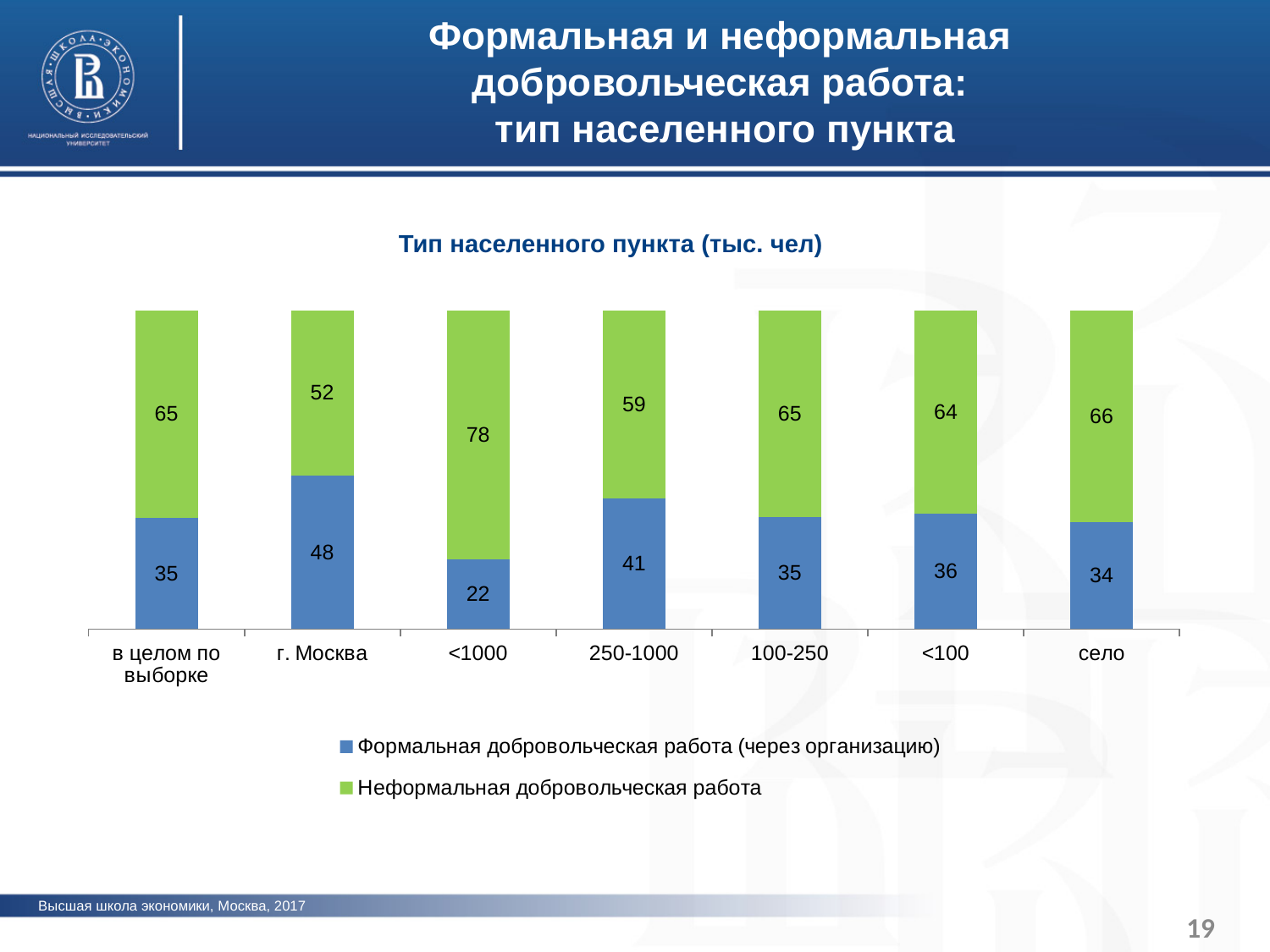
How many series does the legend list? 2 Which category has the lowest value for formal volunteer work (Формальная добровольческая работа)? <1000 Which is larger: the formal volunteer work value for 250-1000 or for 100-250? 250-1000 How many categories are shown on the x axis? 7 What kind of chart is shown on the slide? Stacked bar chart What is the total of the stacked bar for г. Москва? 100 Which category has the highest value for formal volunteer work (Формальная добровольческая работа)? г. Москва What is the value for formal volunteer work (Формальная добровольческая работа) in г. Москва? 48 What is the value for formal volunteer work in the село category? 34 What is the value for informal volunteer work (Неформальная добровольческая работа) for the <1000 category? 78 Which category has the highest value for informal volunteer work (Неформальная добровольческая работа)? <1000 What is the difference between the informal and formal volunteer work values for the <1000 category? 56